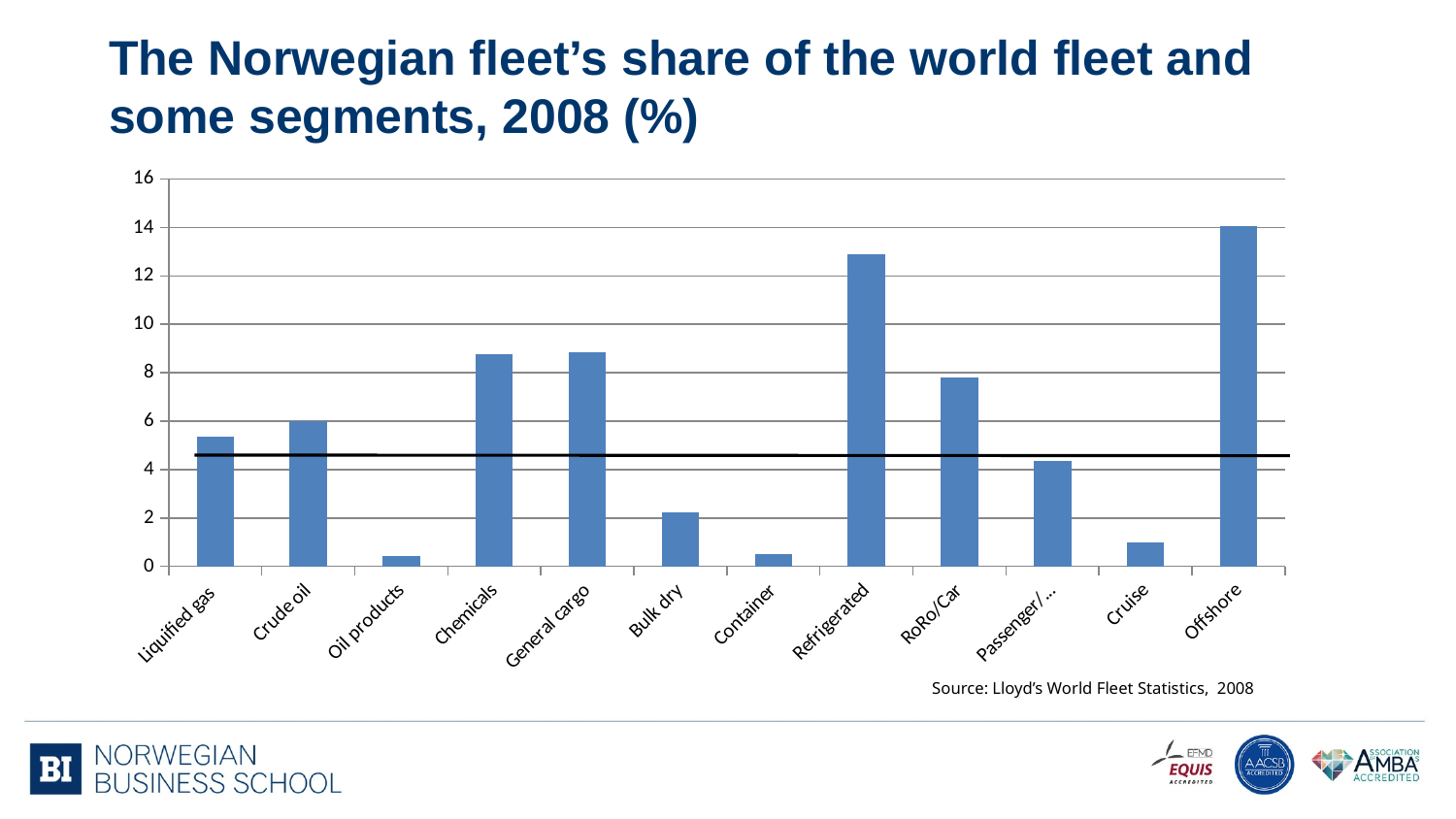
Which is larger, the value for Refrigerated or the value for RoRo/Car? Refrigerated Is the value for Offshore greater or less than 16? less Is the value for Liquified gas greater or less than 4? greater Which is larger, the value for Crude oil or the value for Bulk dry? Crude oil Is the value for Chemicals greater or less than 8? greater What kind of chart is shown on the slide? bar chart How many segment categories are plotted on the x axis? 12 Which segment has the highest Norwegian fleet share? Offshore What is the title of the chart on the slide? The Norwegian fleet's share of the world fleet and some segments, 2008 (%)